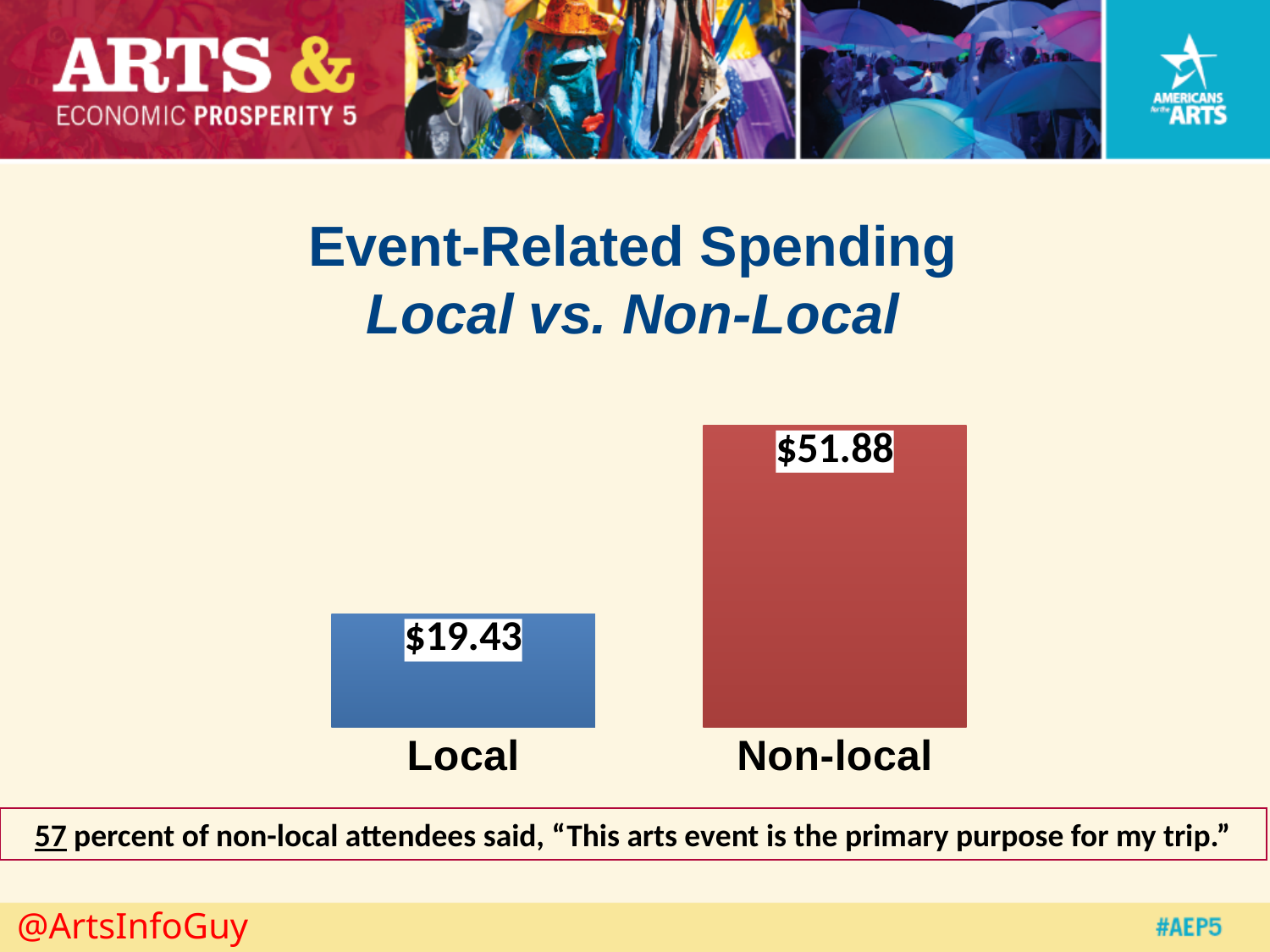
What is the title of the chart? Event-Related Spending Local vs. Non-Local Which category has the lowest event-related spending? Local What kind of chart is shown on the slide? Bar chart What is the difference between Non-local and Local event-related spending? $32.45 What is the event-related spending value for Local attendees? $19.43 What is the event-related spending value for Non-local attendees? $51.88 How many categories are shown in the chart? 2 What colour is the bar for Non-local attendees? Red Which category has the highest event-related spending? Non-local Which is larger, the spending for Local or for Non-local attendees? Non-local